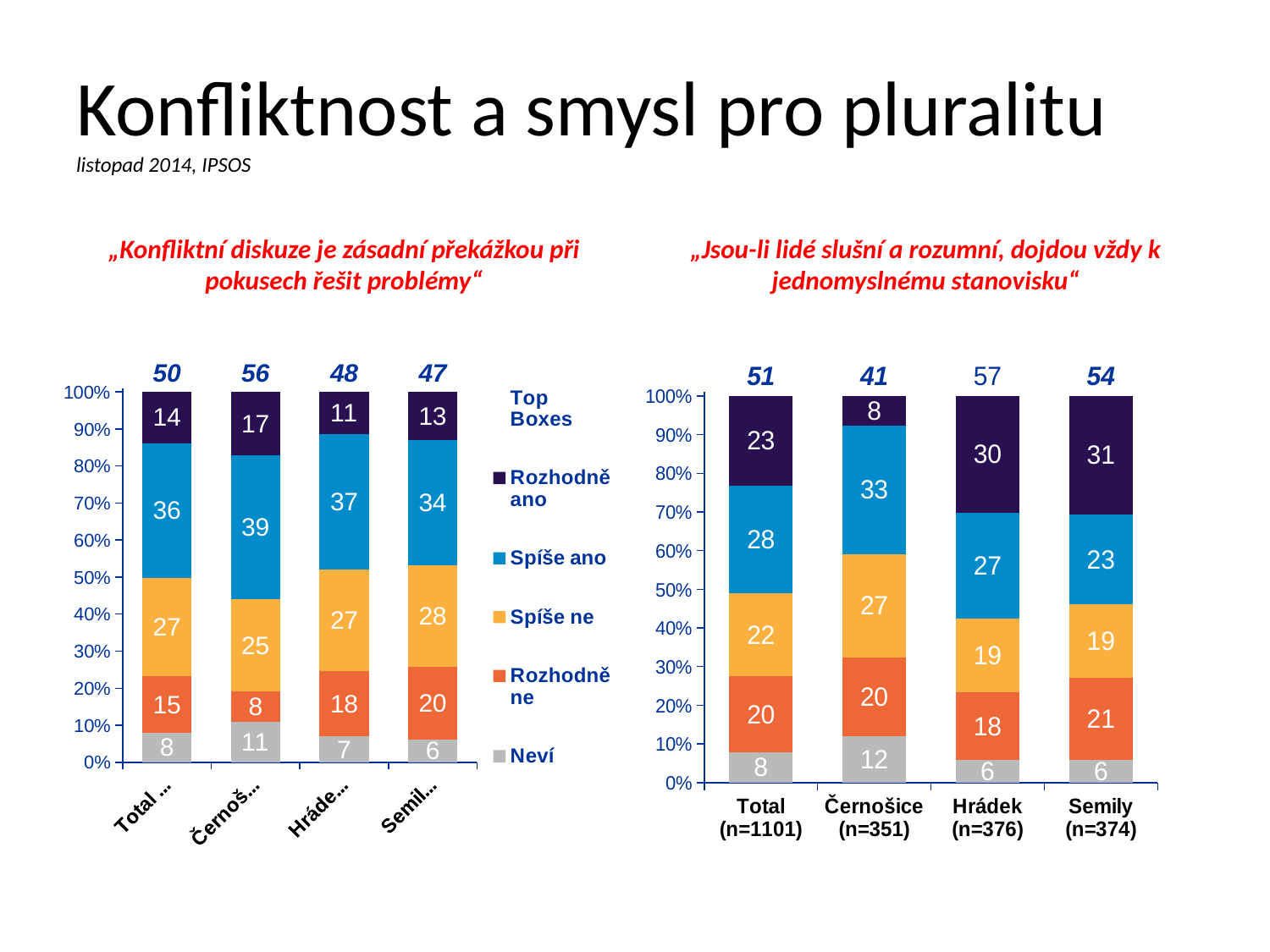
How many coloured data series does the legend list? 5 In the right chart, what is the difference between the "Rozhodně ano" values for Semily (n=374) and Černošice (n=351)? 23 In the right chart, which has the larger "Spíše ano" value: Černošice (n=351) or Hrádek (n=376)? Černošice (n=351) Which series is shown in grey in the legend? Neví In the right chart ("Jsou-li lidé slušní a rozumní..."), what is the value of "Rozhodně ano" for Hrádek (n=376)? 30 What type of chart is used on this slide? Stacked bar chart In the right chart, which category has the lowest Top Boxes value shown above the bars? Černošice (n=351) In the right chart, which category has the highest Top Boxes value shown above the bars? Hrádek (n=376) In the left chart ("Konfliktní diskuze je zásadní překážkou..."), what is the value of "Spíše ano" for Total? 36 In the right chart, what is the "Neví" value for Černošice (n=351)? 12 How many categories are shown on the x axis of the right chart? 4 In the left chart, what is the Top Boxes value shown above the Total bar? 50